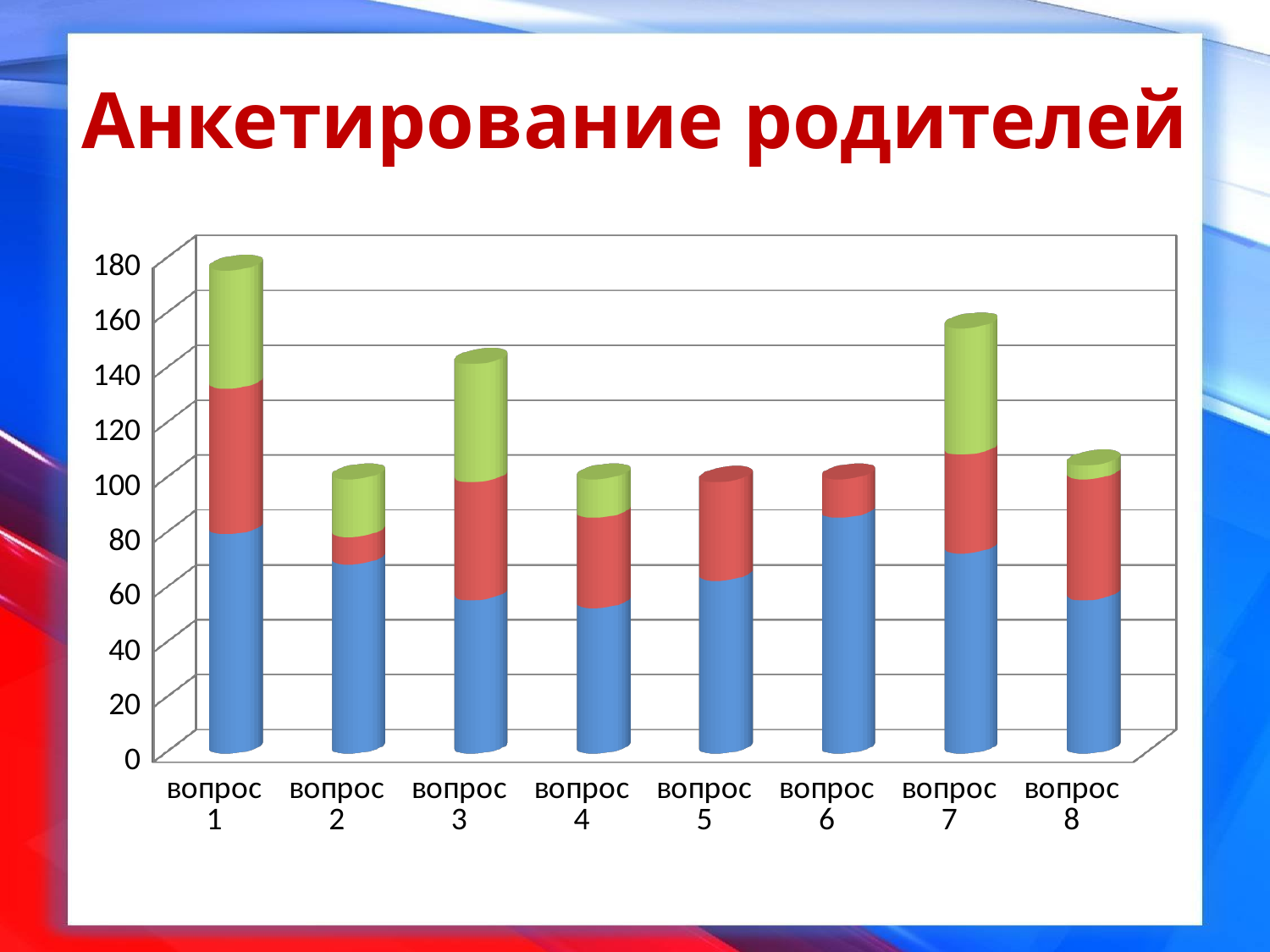
Is the total for вопрос 1 greater or less than 160? greater What kind of chart is shown on the slide? Stacked bar chart Which has the larger total bar, вопрос 1 or вопрос 7? вопрос 1 What is the title of the slide containing the chart? Анкетирование родителей How many categories (вопрос) are shown on the x axis? 8 Is the total for вопрос 7 greater or less than 140? greater Is the blue segment for вопрос 6 greater or less than 80? greater Which category has the highest total bar? вопрос 1 Which has the larger total bar, вопрос 3 or вопрос 2? вопрос 3 Does the total bar rise or fall from вопрос 1 to вопрос 2? fall